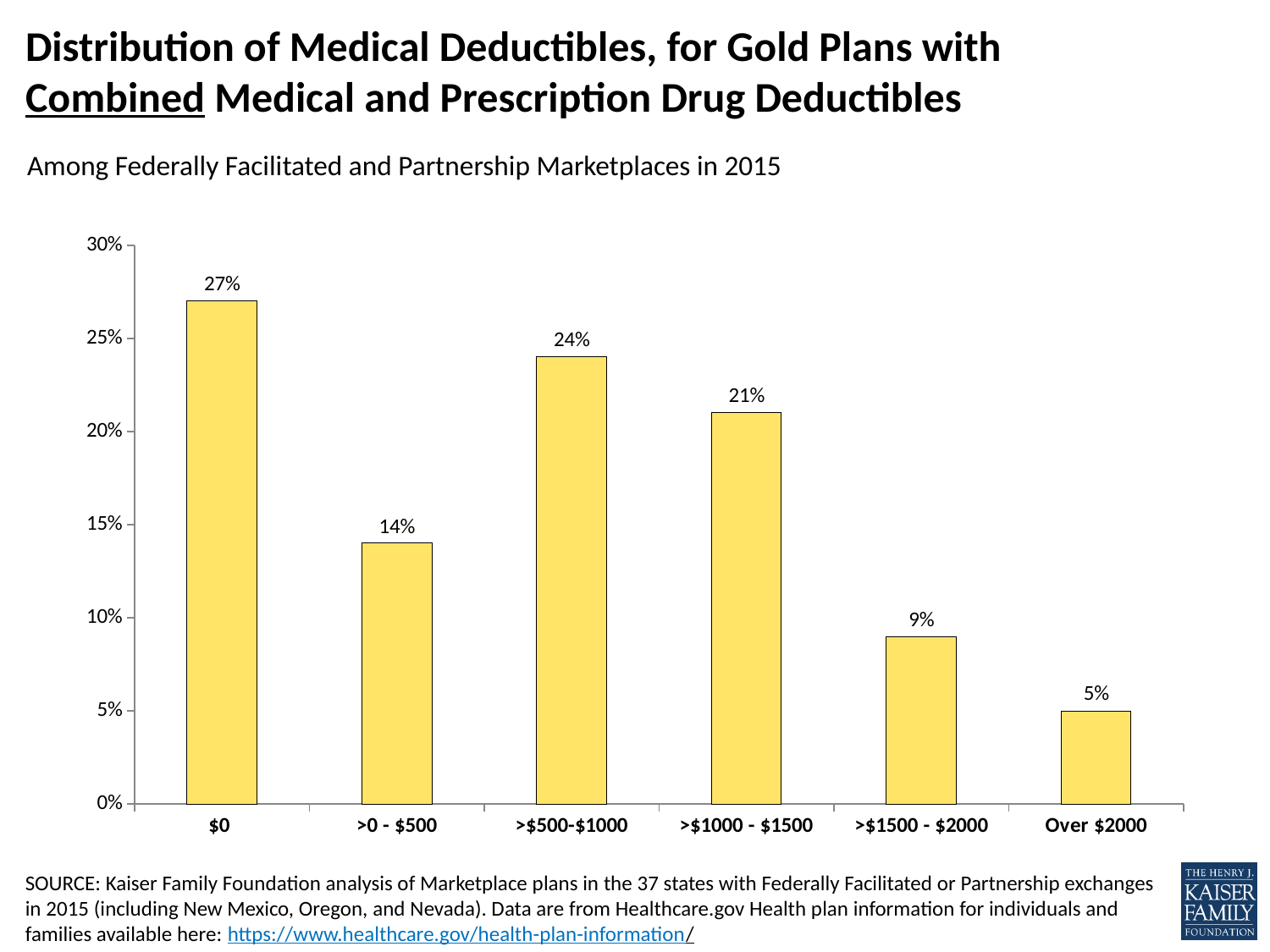
What is the value for the Over $2000 category? 5% What is the value for the >$500-$1000 deductible category? 24% How many deductible categories are shown on the x axis? 6 What is the difference between the >$500-$1000 category and the >$1000 - $1500 category? 3 percentage points What percentage of gold plans have a $0 combined medical deductible? 27% What is the difference between the $0 category and the >0 - $500 category? 13 percentage points Which deductible category has the highest share of plans? $0 Which is larger, the value for >$1000 - $1500 or the value for >$1500 - $2000? >$1000 - $1500 Which deductible category has the lowest share of plans? Over $2000 Is the value for >0 - $500 greater or less than 15%? less What kind of chart is shown on the slide? Bar chart What is the maximum value shown on the y axis? 30%